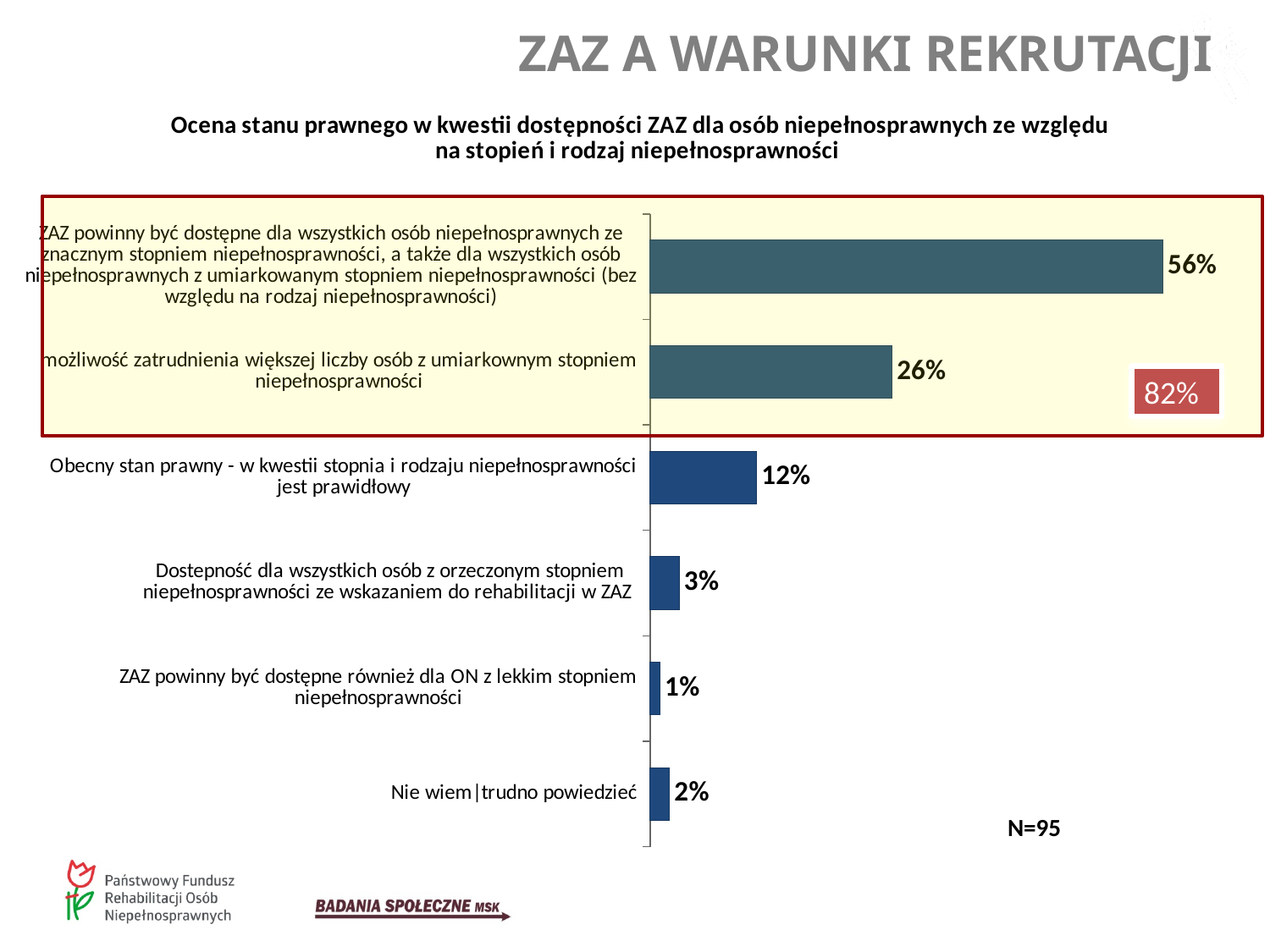
What value is shown for "możliwość zatrudnienia większej liczby osób z umiarkownym stopniem niepełnosprawności"? 26% Which category has the lowest value in the chart? ZAZ powinny być dostępne również dla ON z lekkim stopniem niepełnosprawności What sample size (N) is shown on the slide? N=95 What is the difference between the value for the top category (56%) and "możliwość zatrudnienia większej liczby osób z umiarkownym stopniem niepełnosprawności" (26%)? 30 percentage points Which is larger: the value for "Dostepność dla wszystkich osób z orzeczonym stopniem niepełnosprawności ze wskazaniem do rehabilitacji w ZAZ" or for "Nie wiem|trudno powiedzieć"? Dostepność dla wszystkich osób z orzeczonym stopniem niepełnosprawności ze wskazaniem do rehabilitacji w ZAZ What percentage is shown for "Obecny stan prawny - w kwestii stopnia i rodzaju niepełnosprawności jest prawidłowy"? 12% What combined percentage is shown in the red box for the two highlighted categories? 82% How many categories are shown in the chart? 6 What value is shown for "ZAZ powinny być dostępne również dla ON z lekkim stopniem niepełnosprawności"? 1% What type of chart is shown on the slide? Bar chart What percentage is shown for "Nie wiem|trudno powiedzieć"? 2%